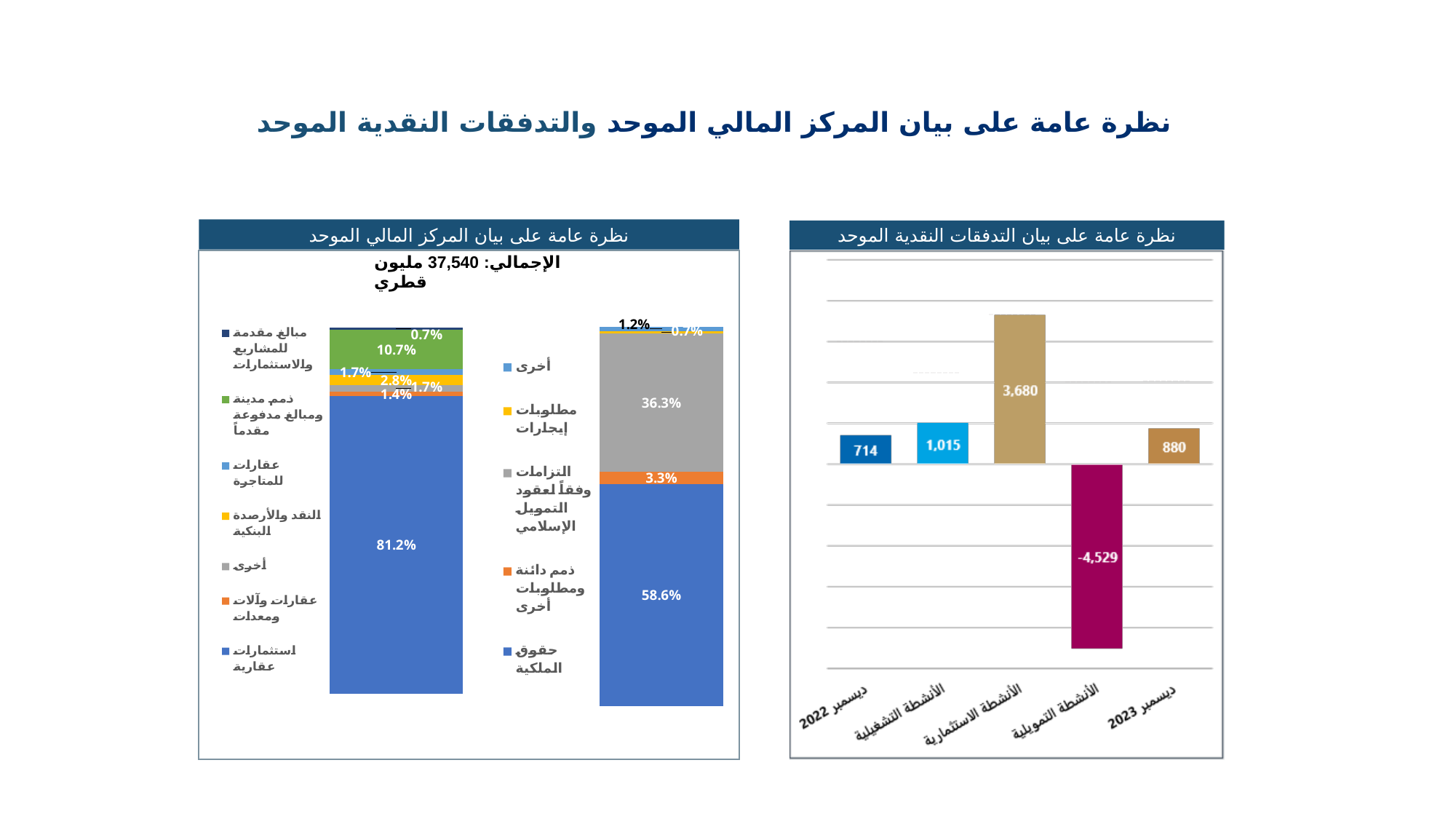
In the cash flow chart (نظرة عامة على بيان التدفقات النقدية الموحد), what is the value for الأنشطة الاستثمارية? 3,680 In the cash flow chart (نظرة عامة على بيان التدفقات النقدية الموحد), how many bars are plotted? 5 In the financial position chart (نظرة عامة على بيان المركز المالي الموحد), what percentage does حقوق الملكية represent? 58.6% In the financial position chart (نظرة عامة على بيان المركز المالي الموحد), what percentage does التزامات وفقاً لعقود التمويل الإسلامي represent in the right stacked bar? 36.3% In the financial position chart (نظرة عامة على بيان المركز المالي الموحد), what total is stated above the stacked bars? 37,540 مليون قطري In the cash flow chart (نظرة عامة على بيان التدفقات النقدية الموحد), what is the value for ديسمبر 2023? 880 In the cash flow chart (نظرة عامة على بيان التدفقات النقدية الموحد), what is the difference between the value for ديسمبر 2023 and the value for ديسمبر 2022? 166 In the cash flow chart (نظرة عامة على بيان التدفقات النقدية الموحد), which is larger: the value for الأنشطة التشغيلية or the value for ديسمبر 2022? الأنشطة التشغيلية In the cash flow chart (نظرة عامة على بيان التدفقات النقدية الموحد), which category has the lowest value? الأنشطة التمويلية In the financial position chart (نظرة عامة على بيان المركز المالي الموحد), what percentage does استثمارات عقارية represent in the left stacked bar? 81.2% In the cash flow chart (نظرة عامة على بيان التدفقات النقدية الموحد), which category has the highest value? الأنشطة الاستثمارية In the cash flow chart (نظرة عامة على بيان التدفقات النقدية الموحد), what is the value for الأنشطة التمويلية? -4,529